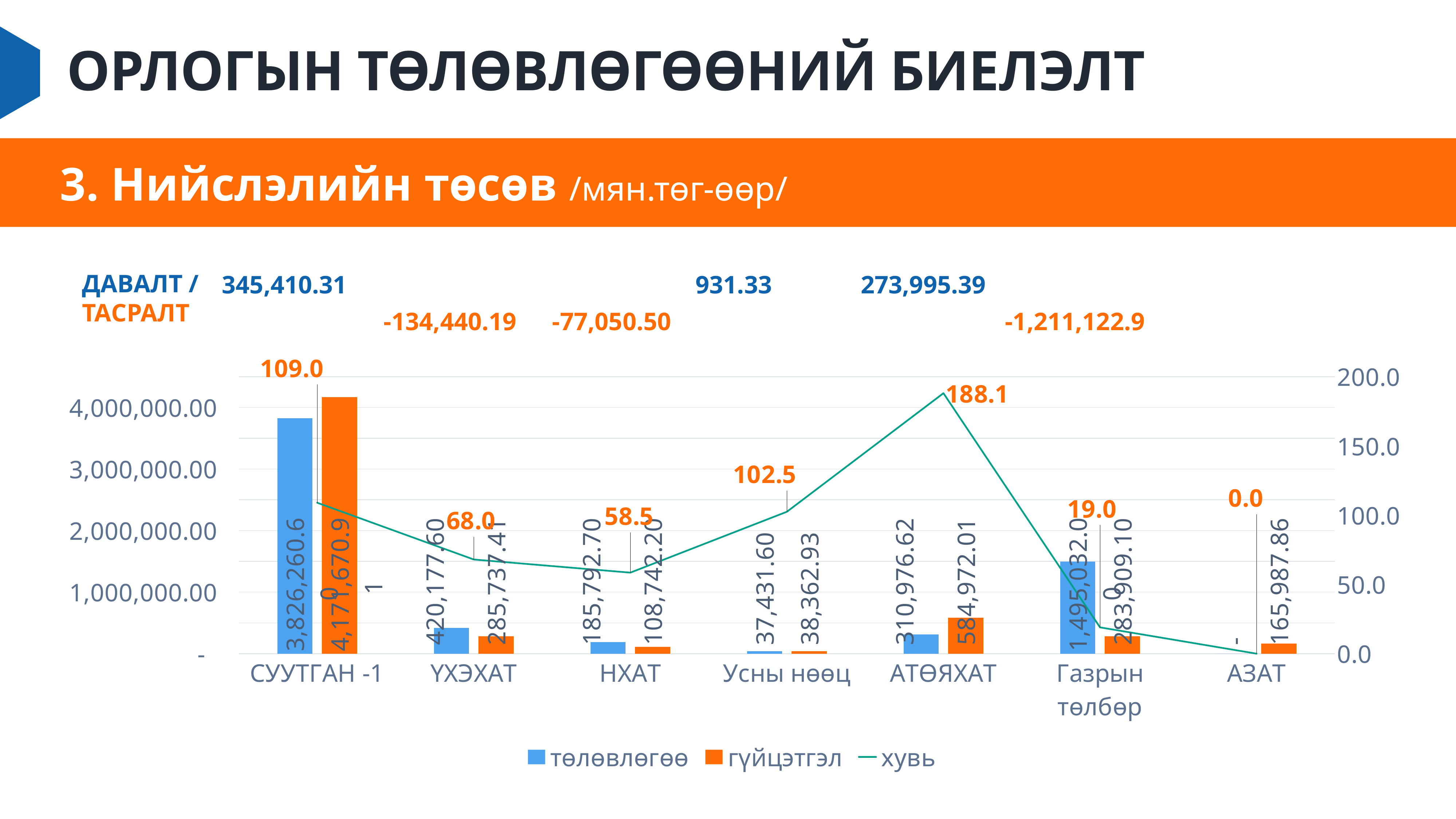
What is the төлөвлөгөө value for ҮХЭХАТ? 420,177.60 What is the хувь value for Газрын төлбөр? 19.0 How many categories are shown on the x axis? 7 Which is larger for Усны нөөц, the төлөвлөгөө value or the гүйцэтгэл value? гүйцэтгэл What is the гүйцэтгэл value for АЗАТ? 165,987.86 Which category has the lowest хувь value? АЗАТ What is the difference between the төлөвлөгөө and гүйцэтгэл values for НХАТ? 77,050.50 Does the хувь line rise or fall from АТӨЯХАТ to АЗАТ? fall What is the гүйцэтгэл value for АТӨЯХАТ? 584,972.01 Which category has the highest хувь value? АТӨЯХАТ Which category has the highest төлөвлөгөө value? СУУТГАН -1 How many series does the legend list? 3